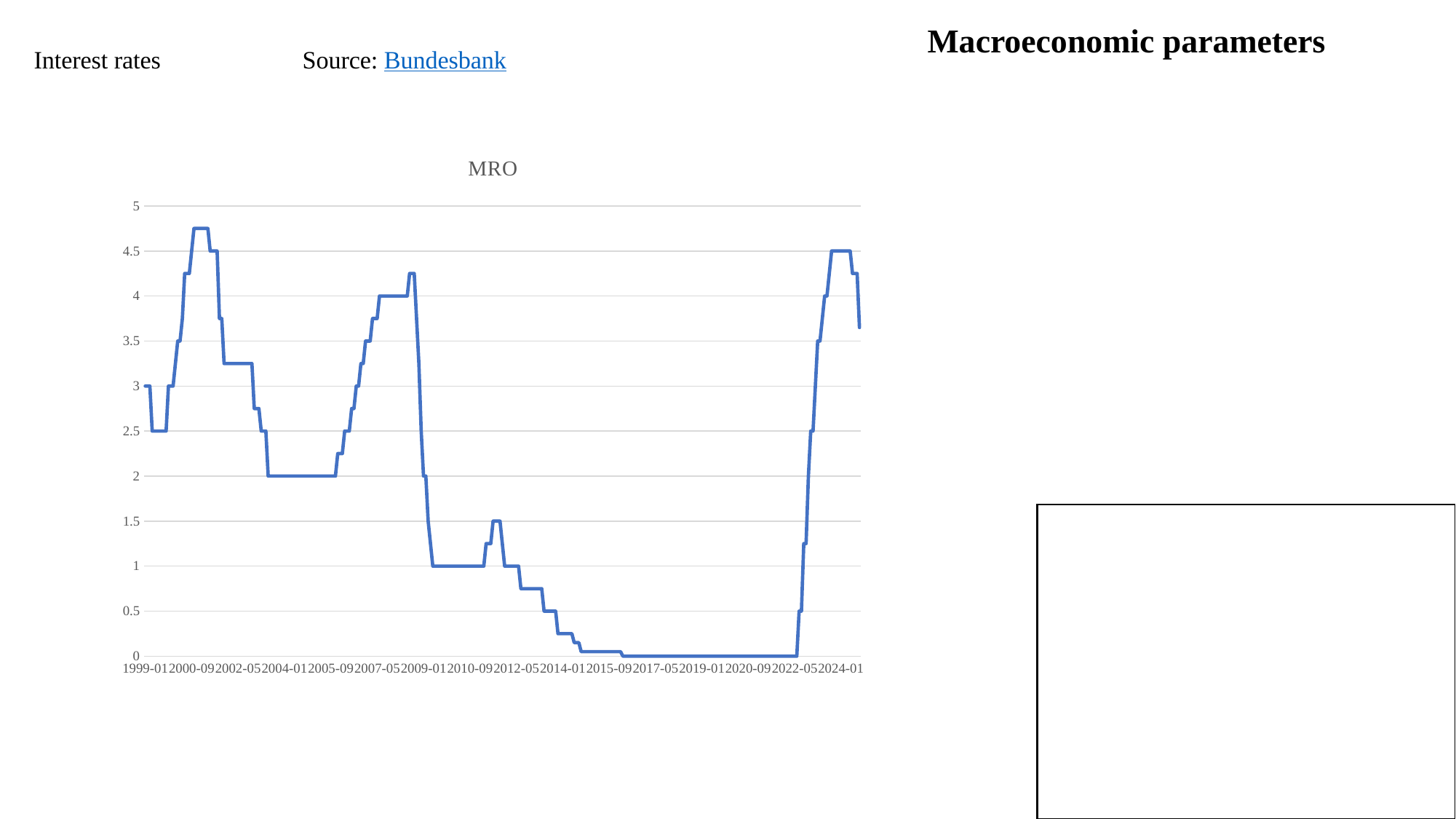
What is the title of the chart? MRO Does the MRO line rise or fall between 2009-01 and 2015-09? fall Is the value for 2024-01 greater or less than 4? greater What value does the MRO line sit at around 2019-01? 0 Is the value for 2002-05 greater or less than 3? greater Is the value for 2014-01 greater or less than 0.5? less What is the source cited for the interest rate chart? Bundesbank What value does the MRO line sit at around 2004-01? 2 What value does the MRO line sit at around 2010-09? 1 Does the MRO line rise or fall between 2022-05 and 2024-01? rise What kind of chart is shown on the slide? line chart